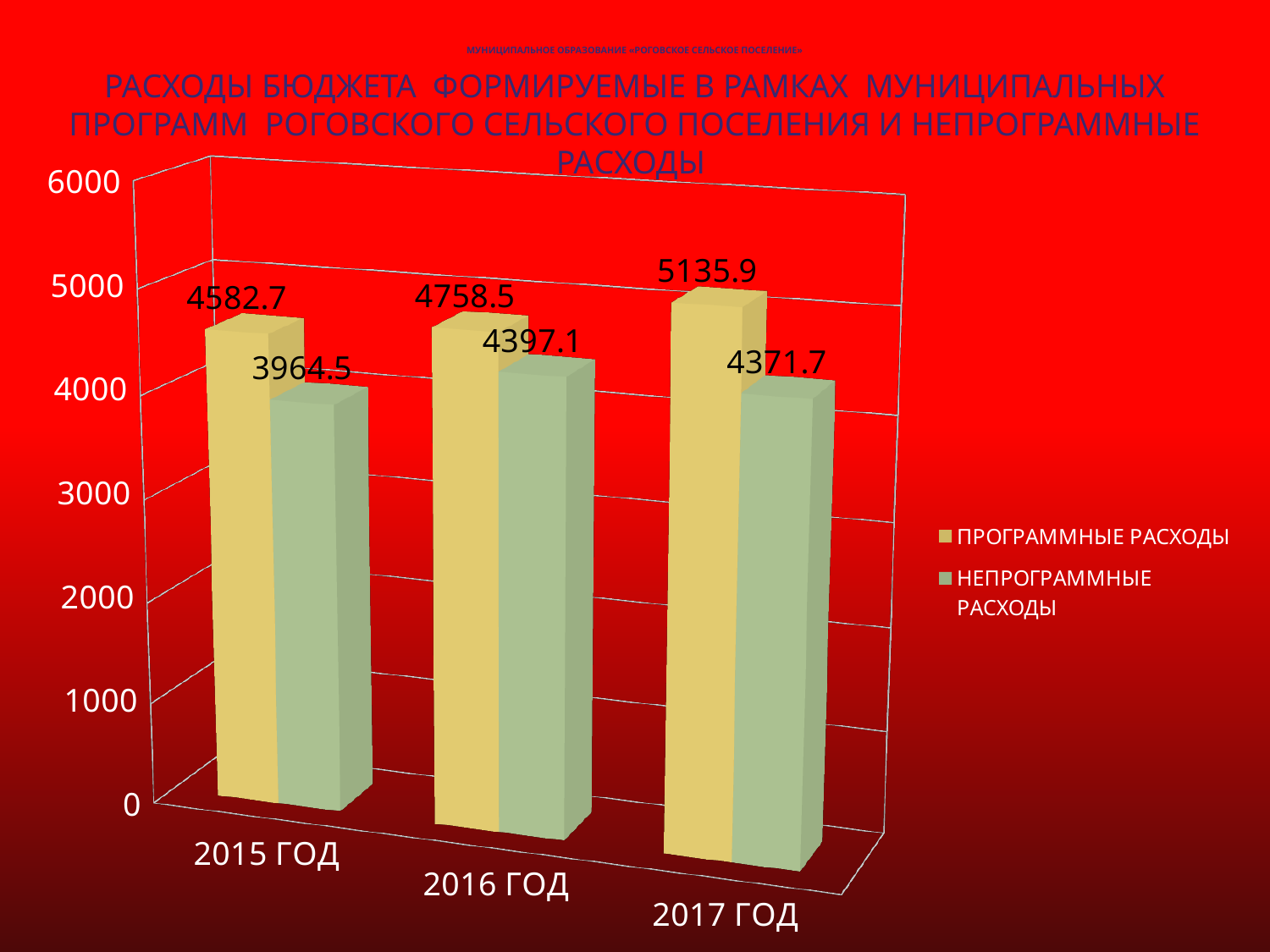
Is the value of ПРОГРАММНЫЕ РАСХОДЫ for 2017 ГОД greater or less than 5000? greater What is the value of ПРОГРАММНЫЕ РАСХОДЫ for 2015 ГОД? 4582.7 In which year is НЕПРОГРАММНЫЕ РАСХОДЫ the lowest? 2015 ГОД Does ПРОГРАММНЫЕ РАСХОДЫ rise or fall from 2015 ГОД to 2017 ГОД? rise What is the value of НЕПРОГРАММНЫЕ РАСХОДЫ for 2016 ГОД? 4397.1 What is the value of НЕПРОГРАММНЫЕ РАСХОДЫ for 2017 ГОД? 4371.7 In which year is ПРОГРАММНЫЕ РАСХОДЫ the highest? 2017 ГОД How many years are shown on the x axis of the chart? 3 By how much did ПРОГРАММНЫЕ РАСХОДЫ increase from 2015 ГОД to 2016 ГОД? 175.8 What is the difference between ПРОГРАММНЫЕ РАСХОДЫ and НЕПРОГРАММНЫЕ РАСХОДЫ in 2015 ГОД? 618.2 How many series does the legend list? 2 Which is larger in 2017 ГОД: ПРОГРАММНЫЕ РАСХОДЫ or НЕПРОГРАММНЫЕ РАСХОДЫ? ПРОГРАММНЫЕ РАСХОДЫ